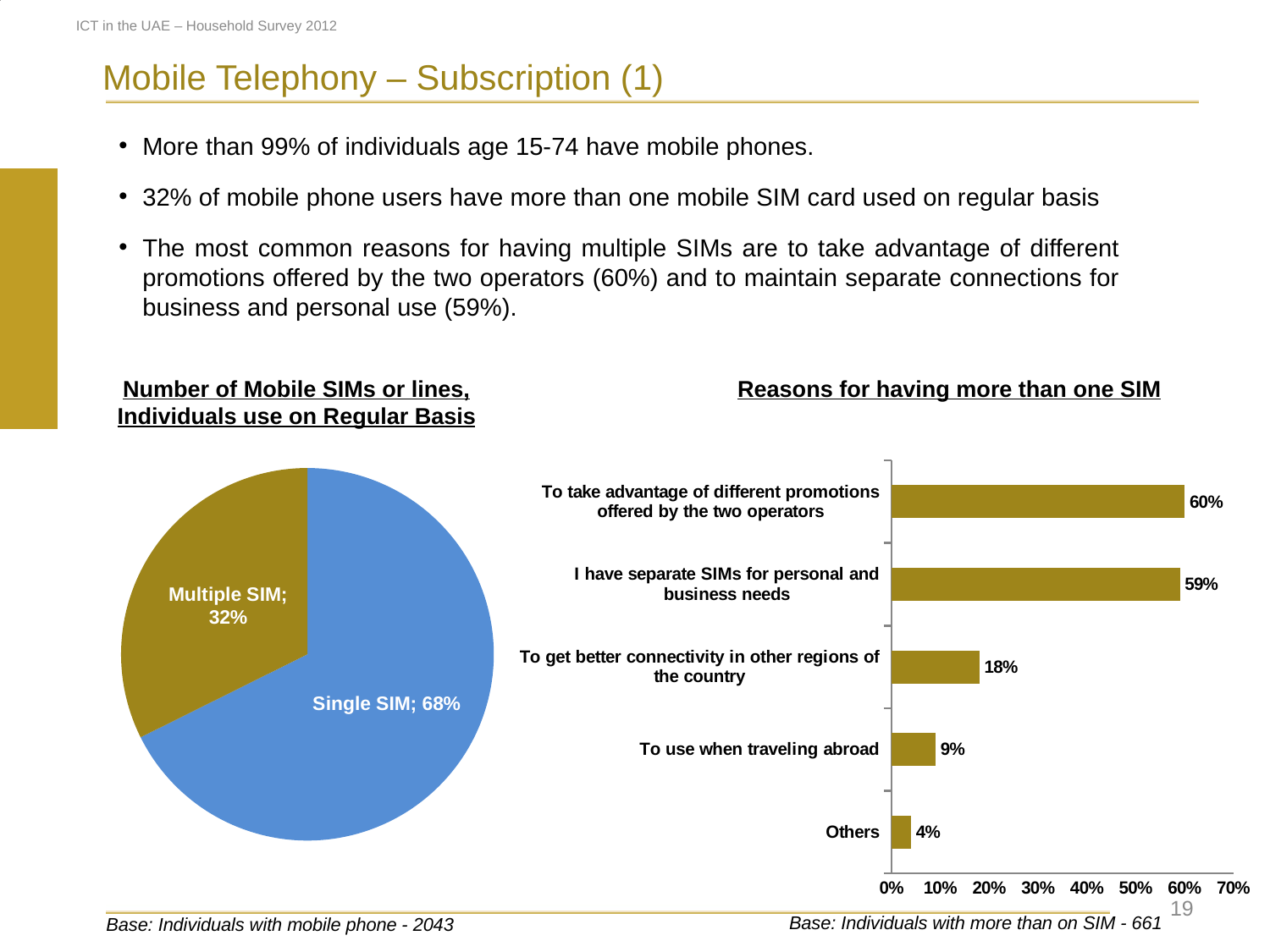
In the 'Reasons for having more than one SIM' chart, which is larger: 'To get better connectivity in other regions of the country' or 'To use when traveling abroad'? To get better connectivity in other regions of the country In the 'Number of Mobile SIMs or lines, Individuals use on Regular Basis' chart, how many slices does the pie have? 2 What kind of chart is 'Reasons for having more than one SIM'? Bar chart What kind of chart is 'Number of Mobile SIMs or lines, Individuals use on Regular Basis'? Pie chart In the 'Number of Mobile SIMs or lines, Individuals use on Regular Basis' chart, what share of individuals use a Single SIM? 68% In the 'Reasons for having more than one SIM' chart, what is the value for 'To get better connectivity in other regions of the country'? 18% In the 'Number of Mobile SIMs or lines, Individuals use on Regular Basis' chart, what share of individuals use Multiple SIM? 32% In the 'Reasons for having more than one SIM' chart, what is the value for 'To use when traveling abroad'? 9% In the 'Reasons for having more than one SIM' chart, how many reasons are listed? 5 In the 'Reasons for having more than one SIM' chart, what is the difference between 'To take advantage of different promotions offered by the two operators' and 'I have separate SIMs for personal and business needs'? 1% In the 'Reasons for having more than one SIM' chart, which reason has the lowest value? Others In the 'Reasons for having more than one SIM' chart, which reason has the highest value? To take advantage of different promotions offered by the two operators